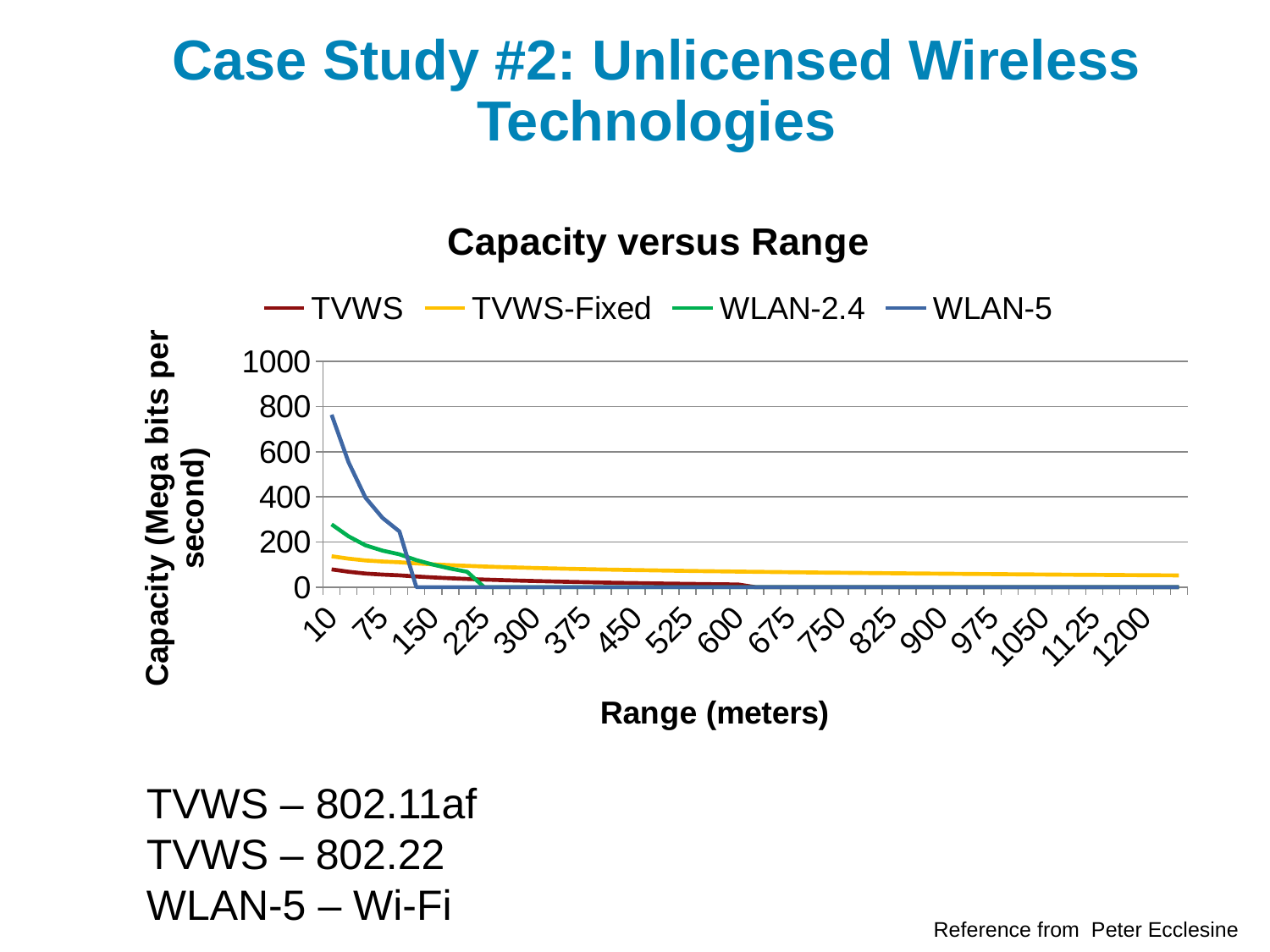
Which series has the highest capacity at a range of 10 meters? WLAN-5 What is the label of the x axis of the chart? Range (meters) How many series does the legend of the chart list? 4 Is the capacity of WLAN-5 at a range of 10 meters greater or less than 600? greater Is the capacity of TVWS-Fixed at a range of 10 meters greater or less than 200? less Which series has the lowest capacity at a range of 10 meters? TVWS Which series still has the highest capacity at a range of 1200 meters? TVWS-Fixed Does the capacity of WLAN-5 rise or fall as the range increases? fall At a range of 10 meters, which is larger: the capacity of WLAN-5 or of WLAN-2.4? WLAN-5 Is the capacity of WLAN-2.4 at a range of 10 meters greater or less than 400? less What is the title of the chart? Capacity versus Range What kind of chart is shown on the slide? line chart